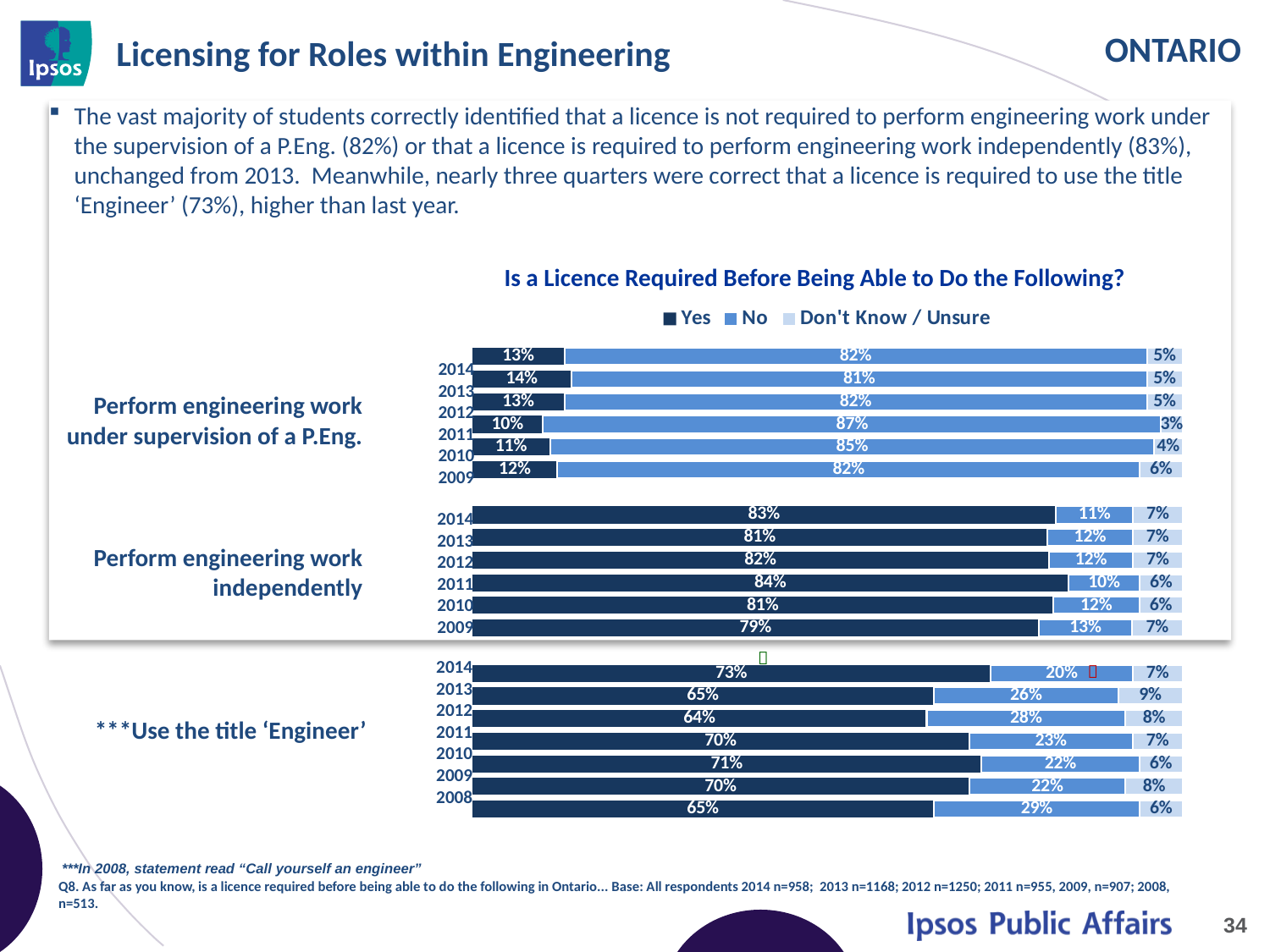
What type of chart is used on this slide? Stacked bar chart In the 'Use the title Engineer' chart, is the 'Yes' percentage larger in 2014 or in 2013? 2014 In the 'Perform engineering work independently' chart, which year has the lowest 'Yes' percentage? 2009 In the 'Use the title Engineer' chart, which year has the highest 'No' percentage? 2008 In the 'Perform engineering work under supervision of a P.Eng.' chart, which year has the highest 'No' percentage? 2011 How many series does the legend list? 3 In the 'Perform engineering work under supervision of a P.Eng.' chart, what percentage answered 'No' in 2014? 82% In the 'Perform engineering work independently' chart, what is the difference between the 'Yes' percentage in 2014 and in 2009? 4 percentage points In the 'Use the title Engineer' chart, what percentage answered 'Yes' in 2014? 73% In the 'Perform engineering work independently' chart, what percentage answered 'Yes' in 2014? 83% How many years are shown in the 'Use the title Engineer' chart? 7 In the 'Perform engineering work under supervision of a P.Eng.' chart, what is the 'Don't Know / Unsure' percentage for 2009? 6%